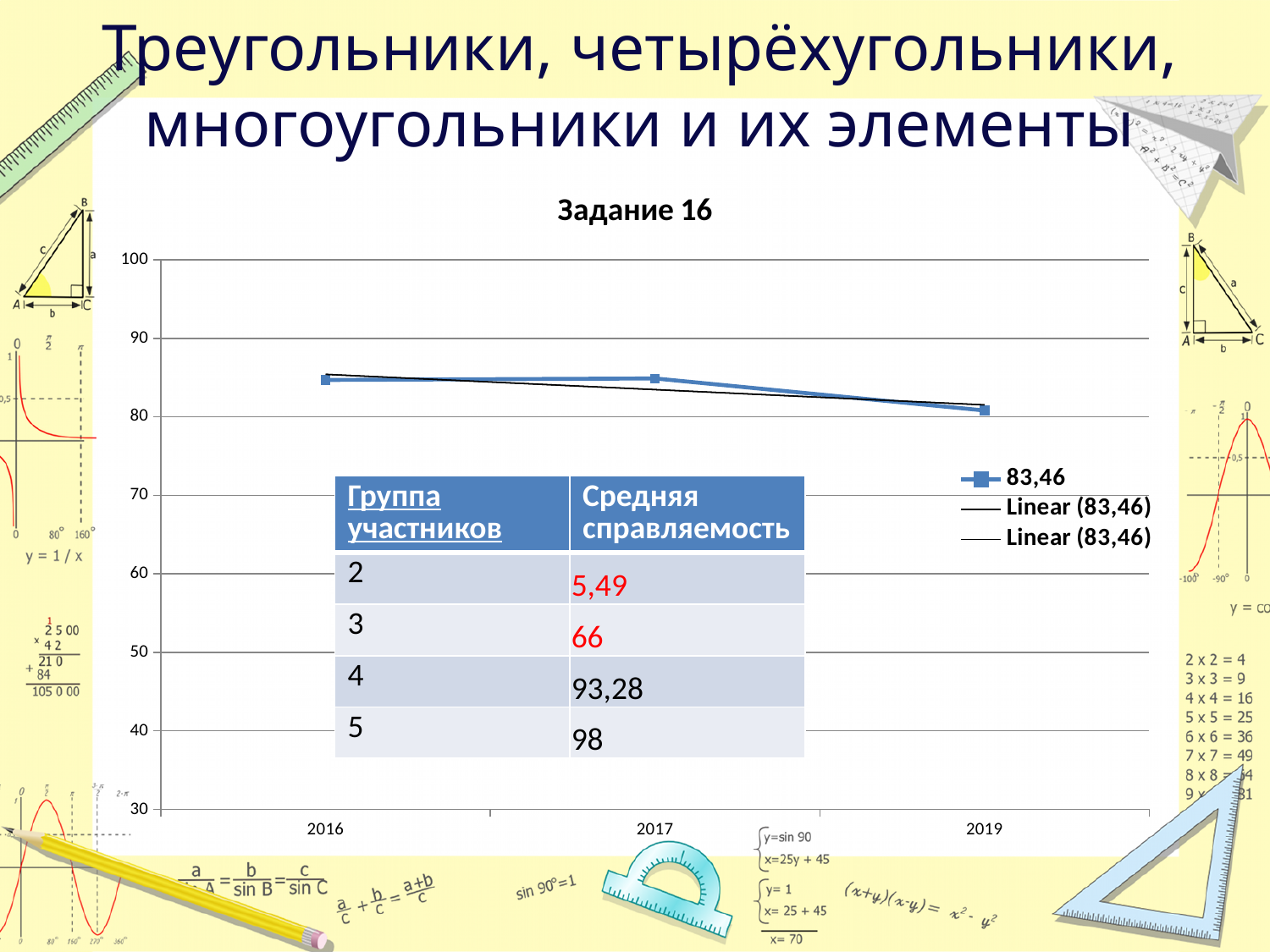
Which year has the lowest value on the chart? 2019 How many entries does the chart legend list? 3 What is the title of the chart? Задание 16 How many data points are plotted on the line in the chart? 3 Is the value for 2019 greater or less than 90? less Which is larger, the value for 2016 or the value for 2019? 2016 What kind of chart is shown on the slide? line chart Is the value for 2017 greater or less than 90? less Is the value for 2016 greater or less than 80? greater What is the name of the plotted data series in the legend? 83,46 Do the values rise or fall from 2017 to 2019? fall